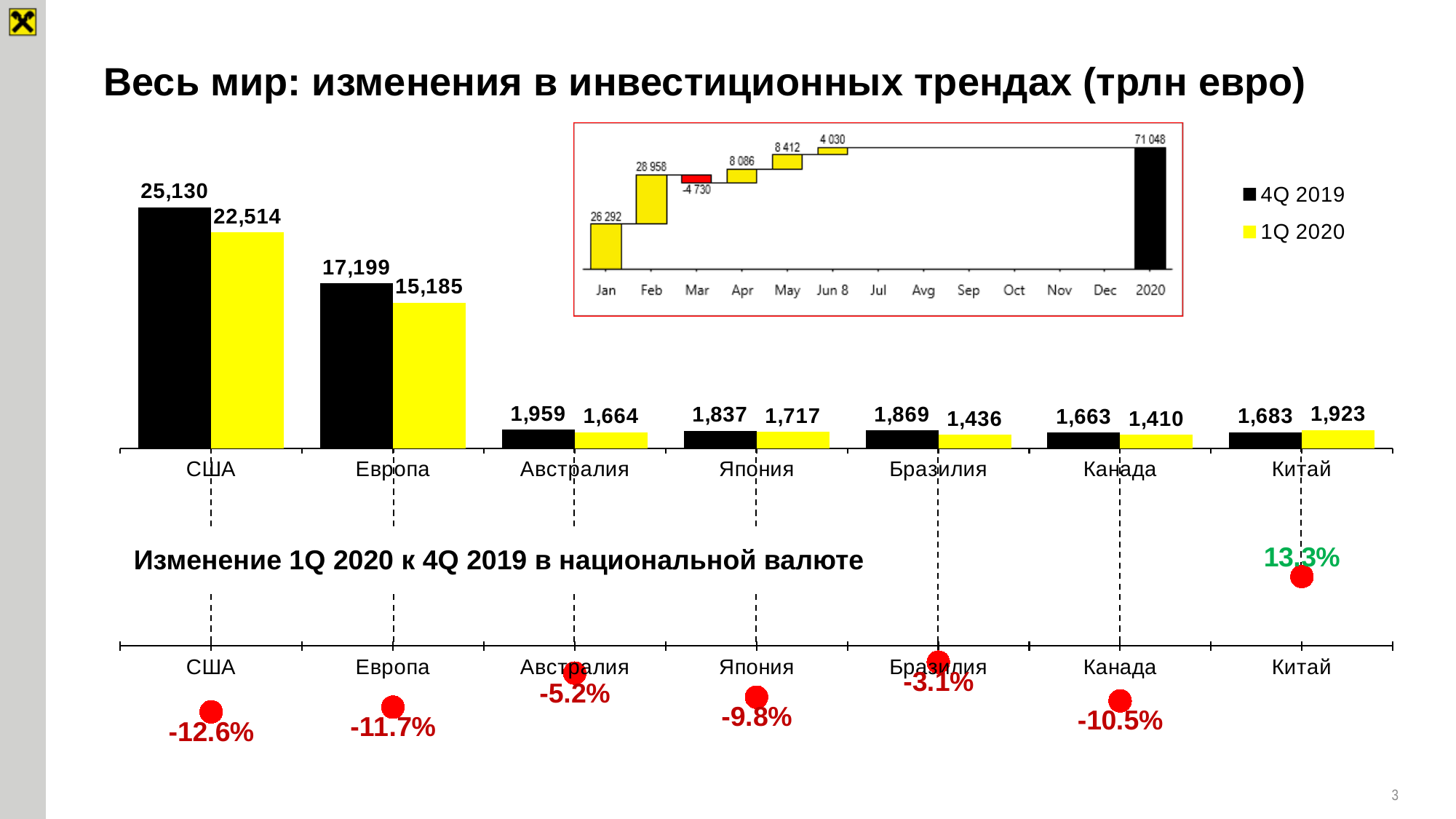
In the main bar chart, what is the 1Q 2020 value for Китай? 1,923 In the lower chart 'Изменение 1Q 2020 к 4Q 2019 в национальной валюте', what is the value for Япония? -9.8% What kind of chart is the main chart comparing 4Q 2019 and 1Q 2020 by region? bar chart In the main bar chart, which category has the lowest 1Q 2020 value? Канада How many categories are shown on the x axis of the main bar chart? 7 In the main bar chart, which is larger for Китай: the 4Q 2019 value or the 1Q 2020 value? 1Q 2020 In the main bar chart, what is the 4Q 2019 value for США? 25,130 In the main bar chart, which category has the highest 4Q 2019 value? США In the lower chart 'Изменение 1Q 2020 к 4Q 2019 в национальной валюте', which category has the only positive value? Китай How many series does the legend of the main bar chart list? 2 In the inset chart at the top right, what is the value shown for Mar? -4 730 In the main bar chart, what is the difference between the 4Q 2019 and 1Q 2020 values for Европа? 2,014